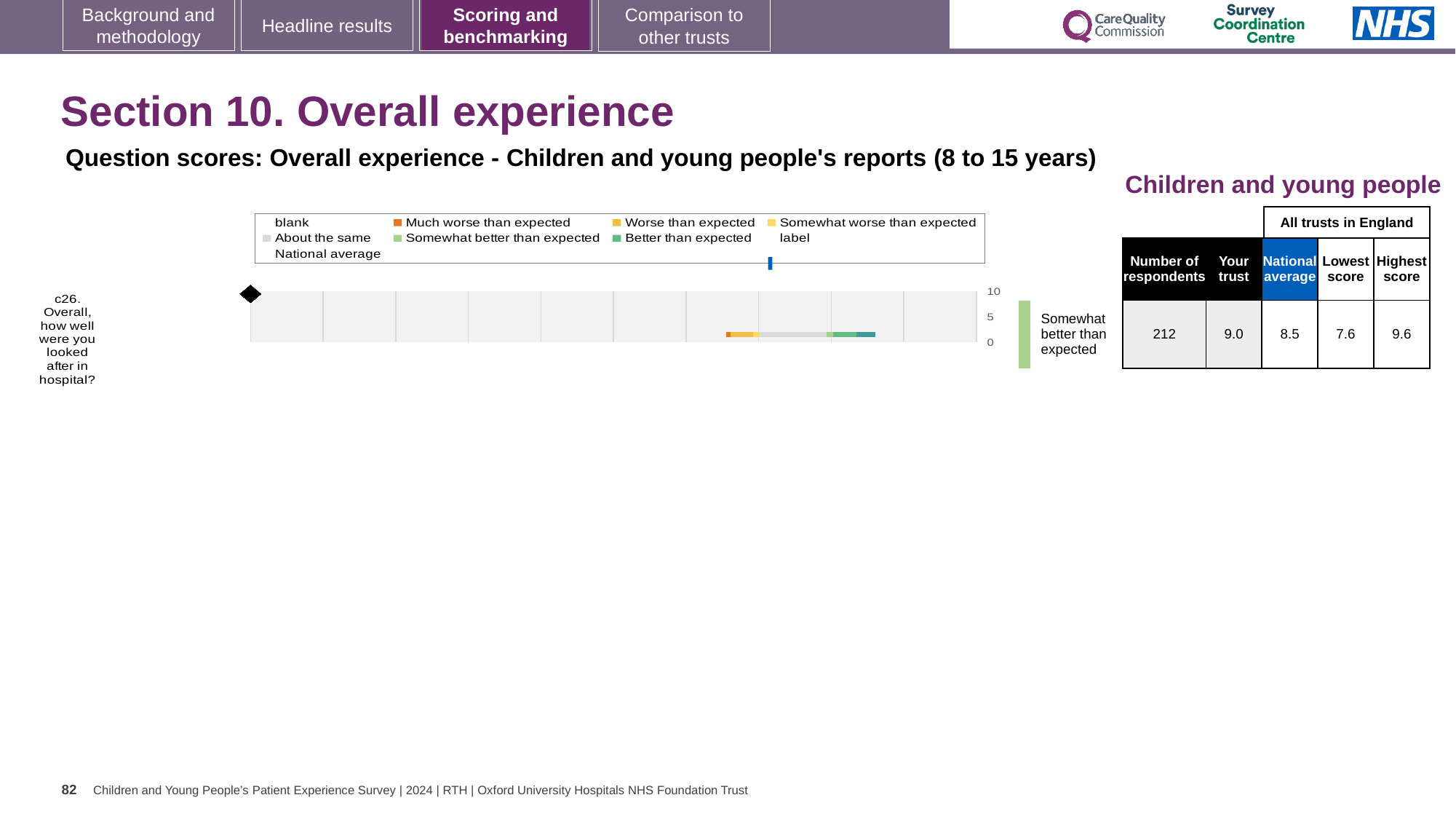
According to the table, what is the national average score for question c26? 8.5 According to the table, what is the highest score among all trusts in England for question c26? 9.6 What is the difference between the highest score and the lowest score for question c26? 2.0 What is the highest value shown on the chart's vertical axis? 10 According to the table, what is the lowest score among all trusts in England for question c26? 7.6 According to the table, how many respondents answered question c26? 212 What kind of chart is used to show the question score for c26? bar chart According to the table, what is the 'Your trust' score for question c26? 9.0 Which is larger for question c26: the 'Your trust' score or the national average? Your trust What is the difference between the 'Your trust' score and the national average for question c26? 0.5 What rating label is shown to the right of the bar for question c26? Somewhat better than expected How many survey questions are plotted on the chart? 1